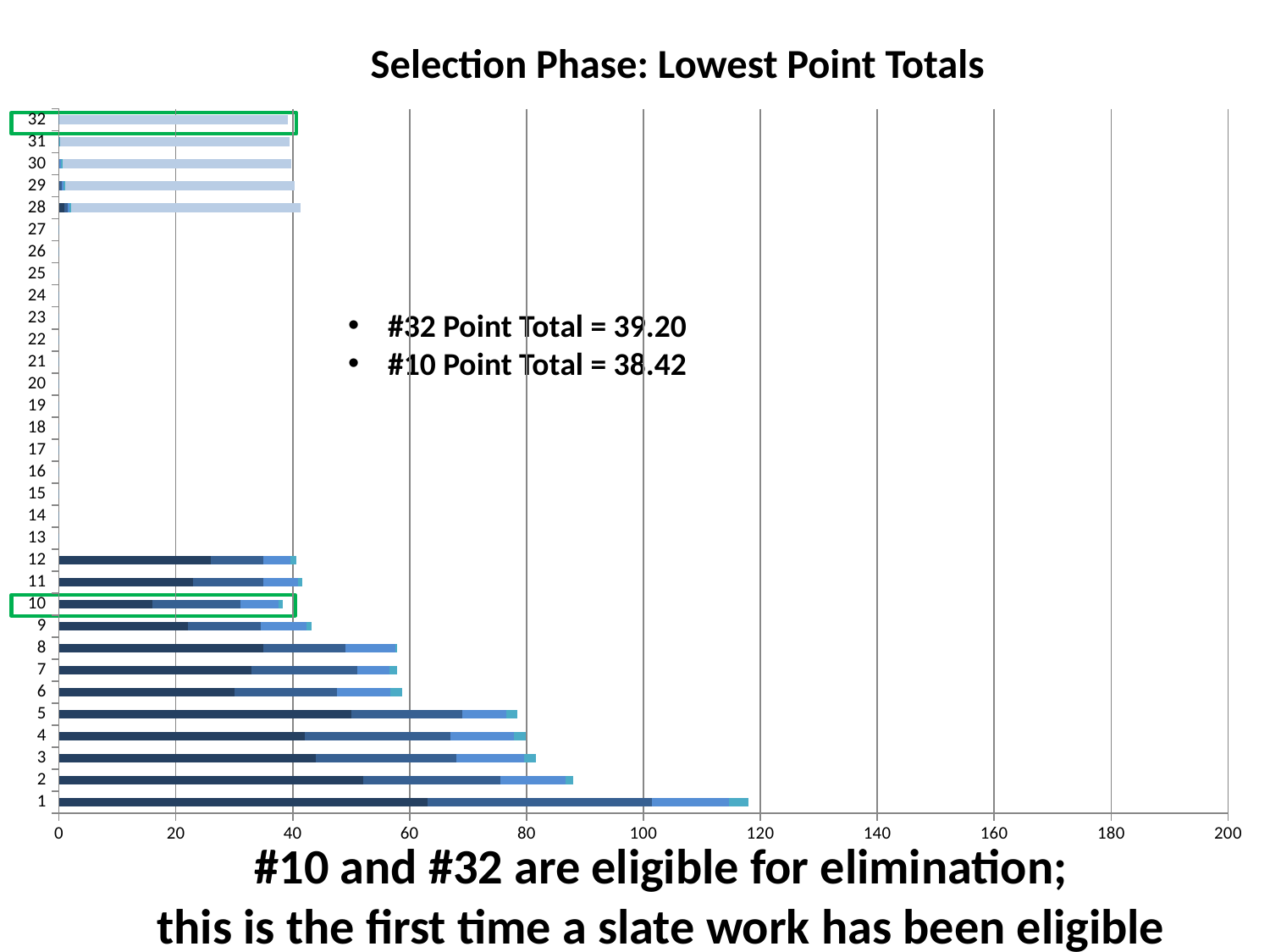
What is the point total for #10 according to the slide? 38.42 What is the point total for #32 according to the slide? 39.20 What kind of chart is shown on the slide? bar chart Is the value for category 1 greater or less than 100? greater Is the value for category 2 greater or less than 100? less What is the title of the chart? Selection Phase: Lowest Point Totals Which category has the longest bar in the chart? 1 Which has the larger value, category 1 or category 2? 1 What is the difference between the point totals of #32 and #10? 0.78 Is the value for category 12 greater or less than 60? less Which two categories are highlighted with green boxes on the chart? 10 and 32 How many categories are labelled on the vertical axis of the chart? 32